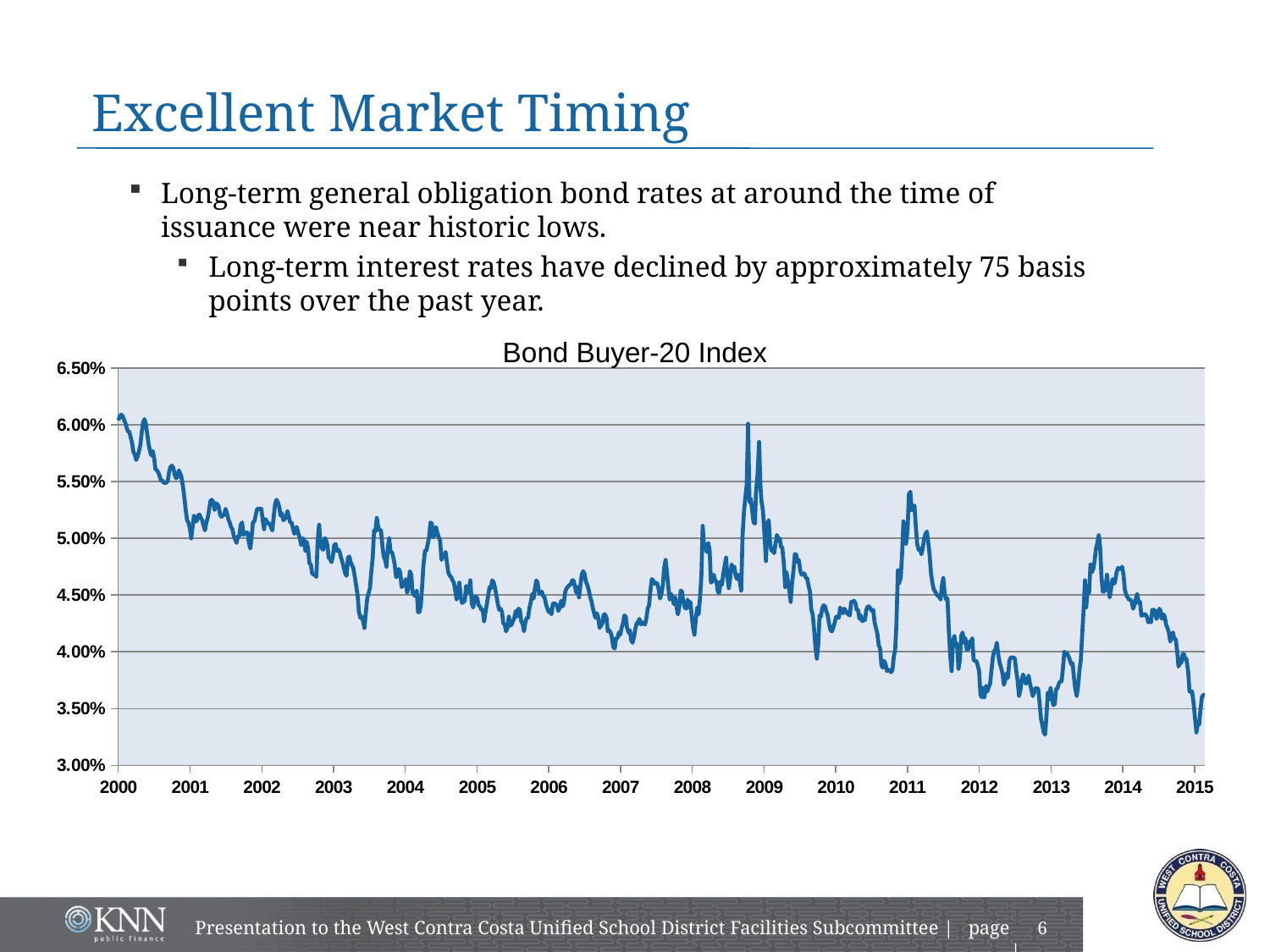
Is the value at the start of 2004 greater or less than 5.00%? less What is the highest value shown on the y axis of the chart? 6.50% Is the value at the start of 2000 greater or less than 5.50%? greater Overall, do the values in the Bond Buyer-20 Index chart rise or fall from 2000 to 2015? fall Which is larger, the value at the start of 2003 or the value at the start of 2013? 2003 How many year labels are shown on the x axis of the chart? 16 What kind of chart is shown on the slide? line chart Is the peak value reached in late 2008 greater or less than 5.50%? greater What is the title of the chart? Bond Buyer-20 Index Which is larger, the value at the start of 2000 or the value at the start of 2015? 2000